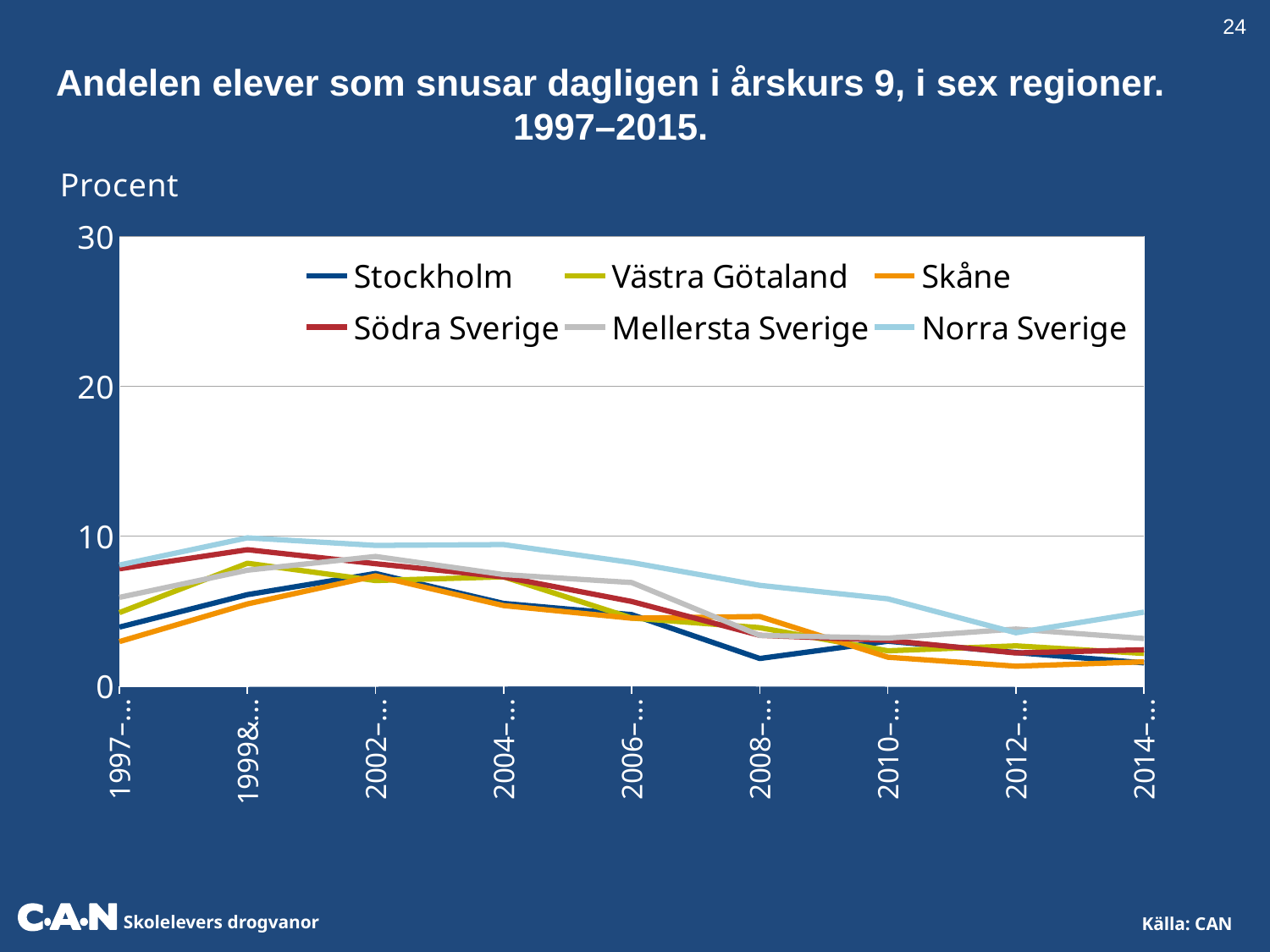
Which series has the lowest value at 2008? Stockholm Is the value for Norra Sverige at 1997 greater or less than 20? less Does the value for Norra Sverige rise or fall overall from 1997 to 2014? fall Which series has the highest value at 2004? Norra Sverige What kind of chart is shown on the slide? line chart What unit is shown on the y axis label? Procent How many series does the legend list? 6 What is the title of the chart? Andelen elever som snusar dagligen i årskurs 9, i sex regioner. 1997–2015. Is the value for Stockholm at 2008 greater or less than 10? less Does the value for Södra Sverige rise or fall overall from 1999 to 2012? fall At 2008, which is larger: the value for Norra Sverige or the value for Stockholm? Norra Sverige Which series has the lowest value at 1997? Skåne